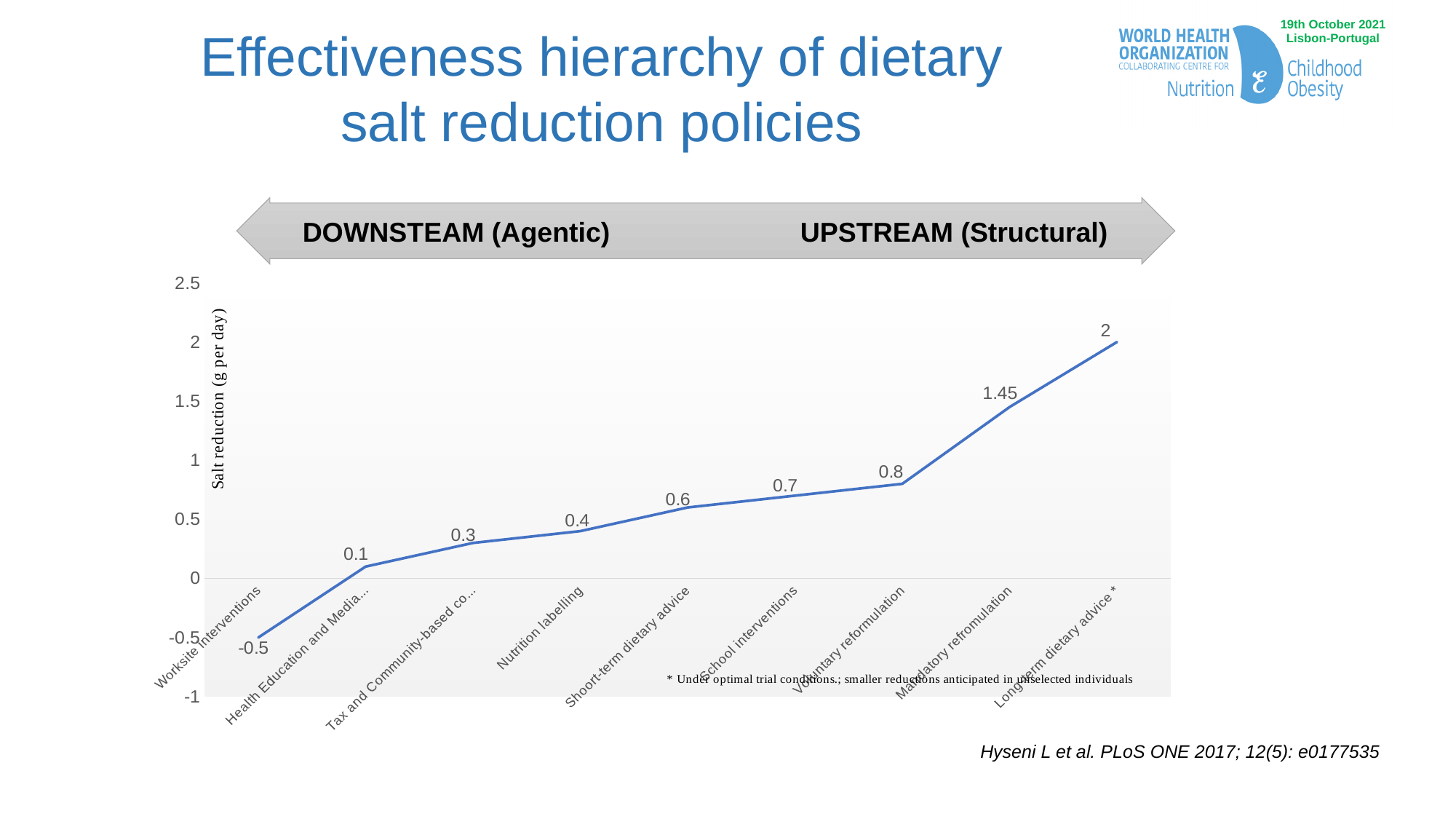
Which category has the highest salt reduction value? Long-term dietary advice * What is the salt reduction value for Mandatory reformulation? 1.45 What is the salt reduction value for Worksite Interventions? -0.5 What is the salt reduction value for School interventions? 0.7 What is the salt reduction value for Nutrition labelling? 0.4 What kind of chart is shown on the slide? Line chart Which has a larger value, Voluntary reformulation or Short-term dietary advice? Voluntary reformulation How many categories are plotted on the x axis? 9 What is the difference between the values for Long-term dietary advice * and Mandatory reformulation? 0.55 Do the values rise or fall from left to right along the x axis? Rise What is the label of the vertical axis? Salt reduction (g per day) Which category has the lowest salt reduction value? Worksite Interventions